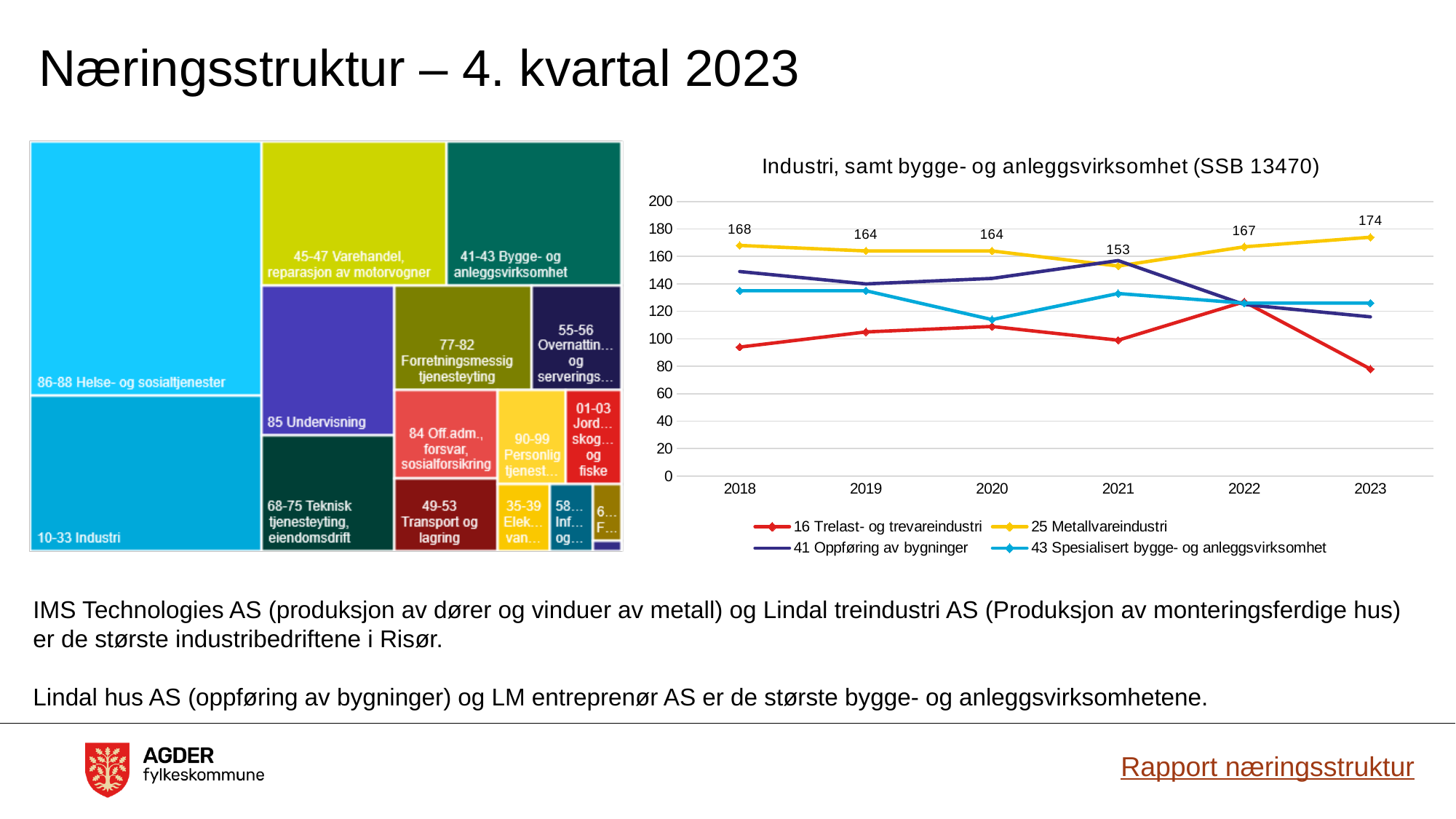
In the line chart 'Industri, samt bygge- og anleggsvirksomhet (SSB 13470)', what is the difference between the 25 Metallvareindustri values for 2023 and 2021? 21 In the line chart 'Industri, samt bygge- og anleggsvirksomhet (SSB 13470)', does the value for 16 Trelast- og trevareindustri rise or fall from 2022 to 2023? fall In the line chart 'Industri, samt bygge- og anleggsvirksomhet (SSB 13470)', how many series does the legend list? 4 What kind of chart is the chart on the right side of the slide? line chart In the line chart 'Industri, samt bygge- og anleggsvirksomhet (SSB 13470)', in which year is 25 Metallvareindustri highest? 2023 In the line chart 'Industri, samt bygge- og anleggsvirksomhet (SSB 13470)', how many years are shown on the x axis? 6 In the line chart 'Industri, samt bygge- og anleggsvirksomhet (SSB 13470)', is the value for 16 Trelast- og trevareindustri in 2023 greater or less than 100? less In the line chart 'Industri, samt bygge- og anleggsvirksomhet (SSB 13470)', what is the value for 25 Metallvareindustri in 2023? 174 In the line chart 'Industri, samt bygge- og anleggsvirksomhet (SSB 13470)', in which year is 25 Metallvareindustri lowest? 2021 In the line chart 'Industri, samt bygge- og anleggsvirksomhet (SSB 13470)', what is the value for 25 Metallvareindustri in 2018? 168 In the line chart 'Industri, samt bygge- og anleggsvirksomhet (SSB 13470)', is the value for 41 Oppføring av bygninger in 2021 greater or less than 140? greater In the line chart 'Industri, samt bygge- og anleggsvirksomhet (SSB 13470)', is the 25 Metallvareindustri value higher in 2018 or in 2022? 2018